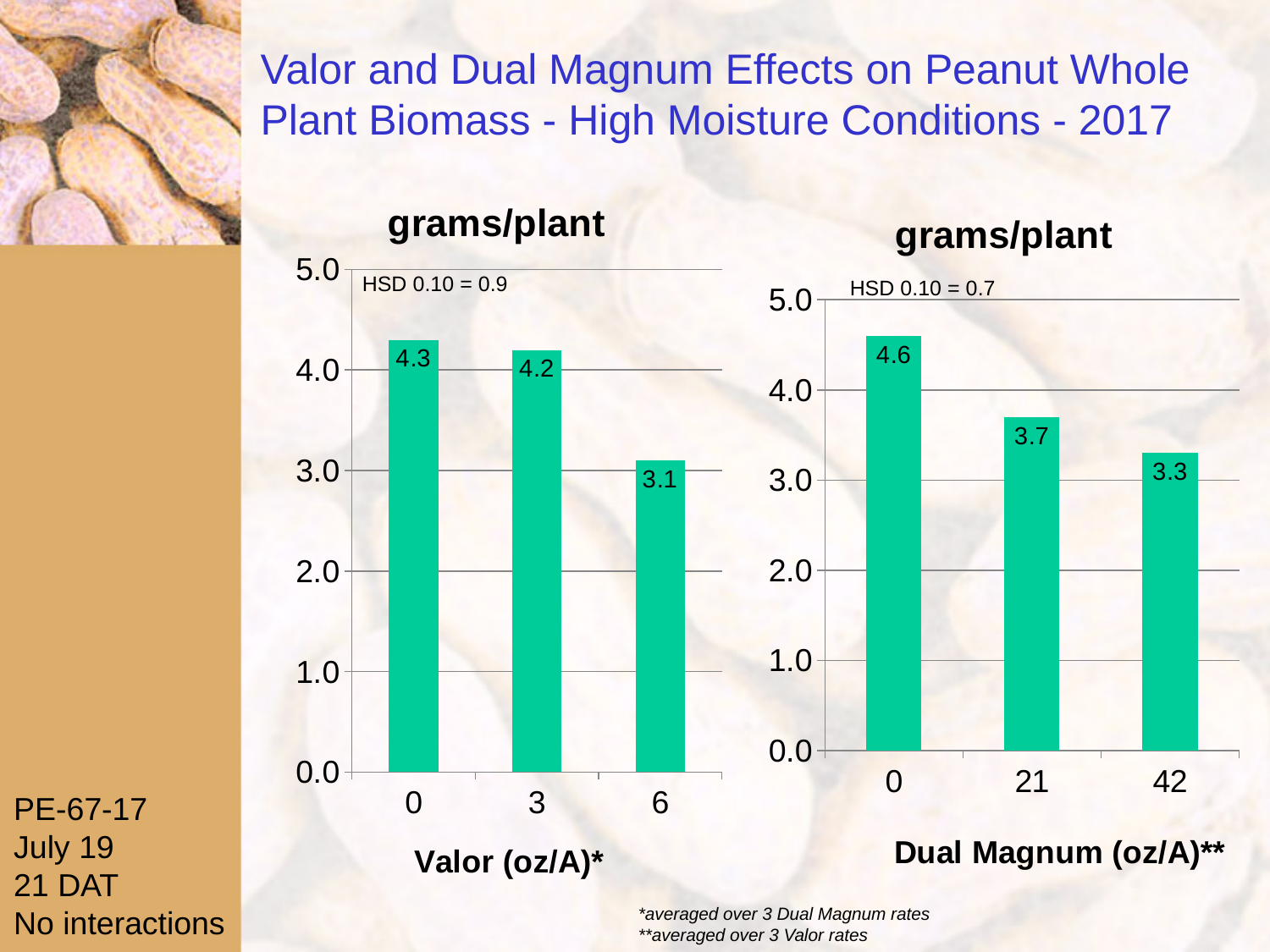
In the right chart (Dual Magnum), what is the difference in grams/plant between the 0 and 42 oz/A rates? 1.3 What kind of chart is the right chart (Dual Magnum)? bar chart In the left chart (Valor), what is the difference in grams/plant between the 0 and 6 oz/A rates? 1.2 What HSD 0.10 value is shown on the left chart (Valor)? 0.9 In the left chart (Valor), which rate has the lowest biomass? 6 In the right chart (Dual Magnum), which rate has the highest biomass? 0 In the right chart (Dual Magnum), what is the biomass in grams/plant at the 21 oz/A rate? 3.7 In the left chart (Valor), what is the biomass in grams/plant at the 6 oz/A rate? 3.1 In the left chart (Valor), what is the biomass in grams/plant at the 0 oz/A rate? 4.3 In the right chart (Dual Magnum), do the biomass values rise or fall as the rate increases? fall In the right chart (Dual Magnum), which rate has the larger biomass, 21 or 42 oz/A? 21 How many Valor rates are plotted in the left chart? 3